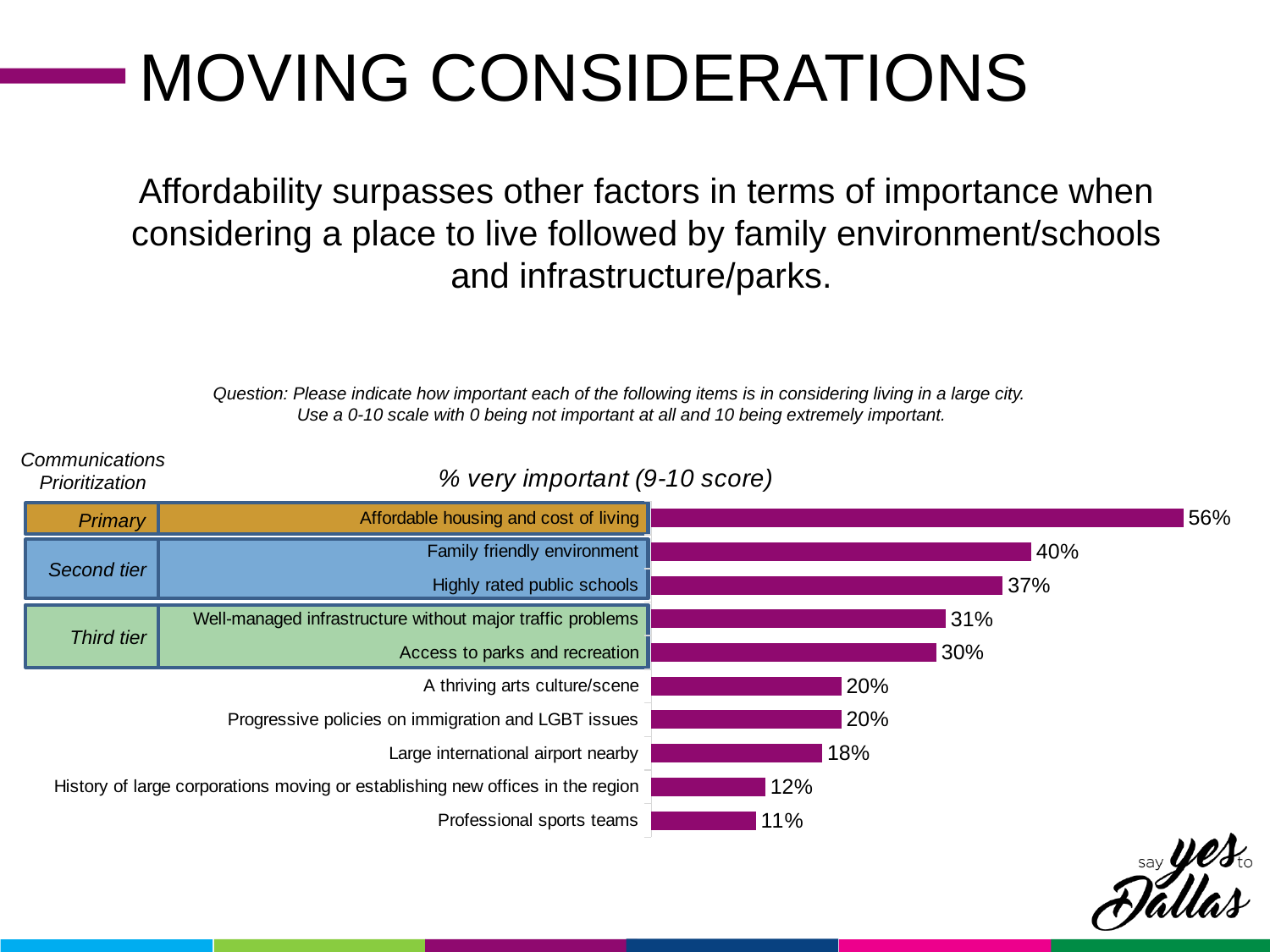
What is the value for 'Highly rated public schools'? 37% What is the difference between 'Affordable housing and cost of living' and 'Professional sports teams'? 45% Which category has the highest percentage? Affordable housing and cost of living What is the difference between 'Family friendly environment' and 'Highly rated public schools'? 3% What is the title of the chart? % very important (9-10 score) Which category has the lowest percentage? Professional sports teams What is the value for 'Large international airport nearby'? 18% What percentage rated 'Affordable housing and cost of living' as very important? 56% Which categories are grouped under 'Second tier' in the Communications Prioritization? Family friendly environment; Highly rated public schools Which is larger: 'Well-managed infrastructure without major traffic problems' or 'Access to parks and recreation'? Well-managed infrastructure without major traffic problems How many categories are shown in the chart? 10 What kind of chart is shown on the slide? Bar chart